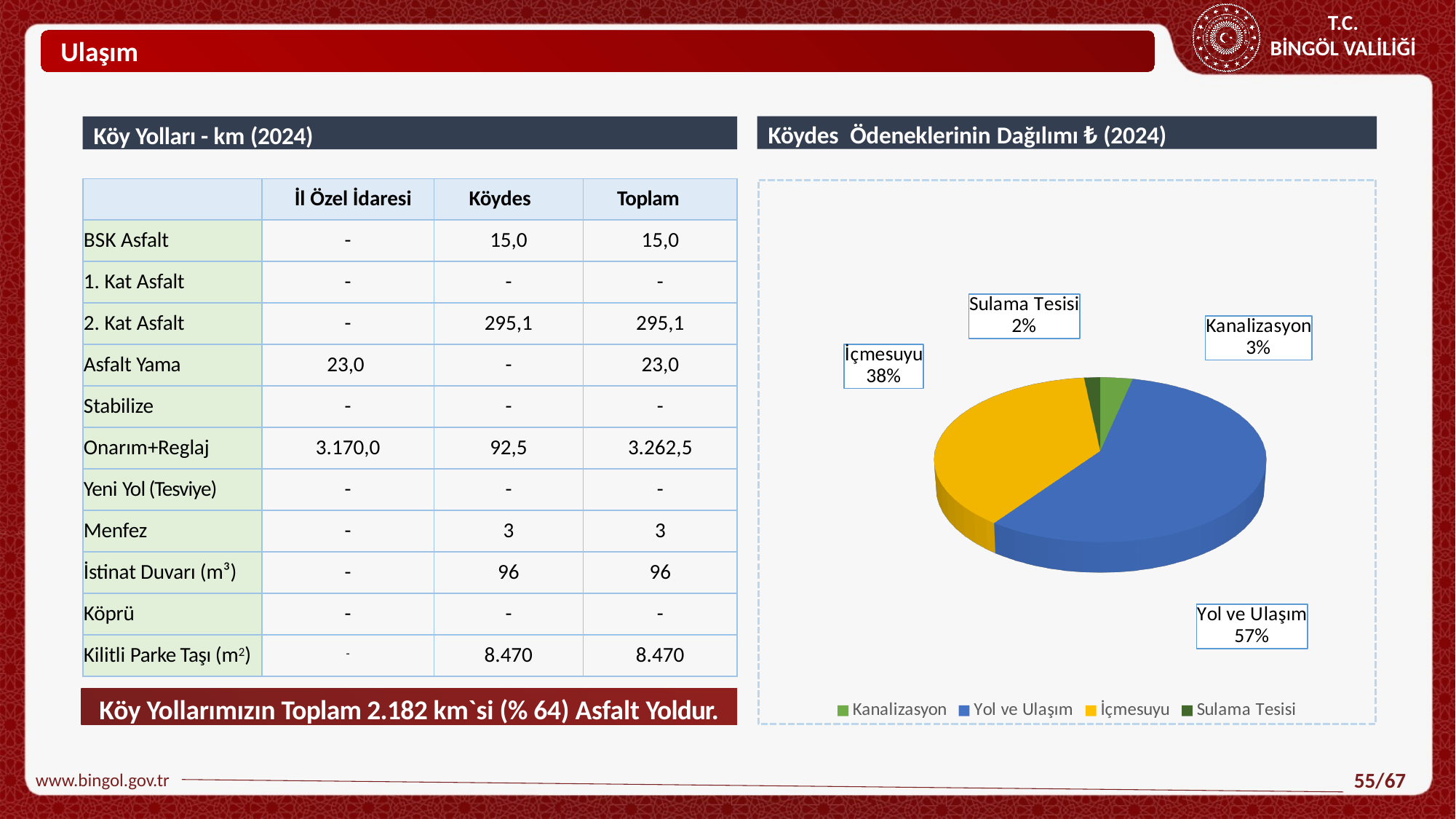
How many slices does the pie chart have? 4 In the pie chart, what share does İçmesuyu have? 38% In the pie chart, which colour represents İçmesuyu? Yellow Which category has the largest slice in the pie chart? Yol ve Ulaşım How many entries does the legend of the pie chart list? 4 In the pie chart, what share does Yol ve Ulaşım have? 57% What kind of chart is shown under the title "Köydes Ödeneklerinin Dağılımı ₺ (2024)"? Pie chart In the pie chart, what is the difference in percentage points between Yol ve Ulaşım and İçmesuyu? 19 In the pie chart, what share does Kanalizasyon have? 3% In the pie chart, which is larger: İçmesuyu or Kanalizasyon? İçmesuyu Which category has the smallest slice in the pie chart? Sulama Tesisi